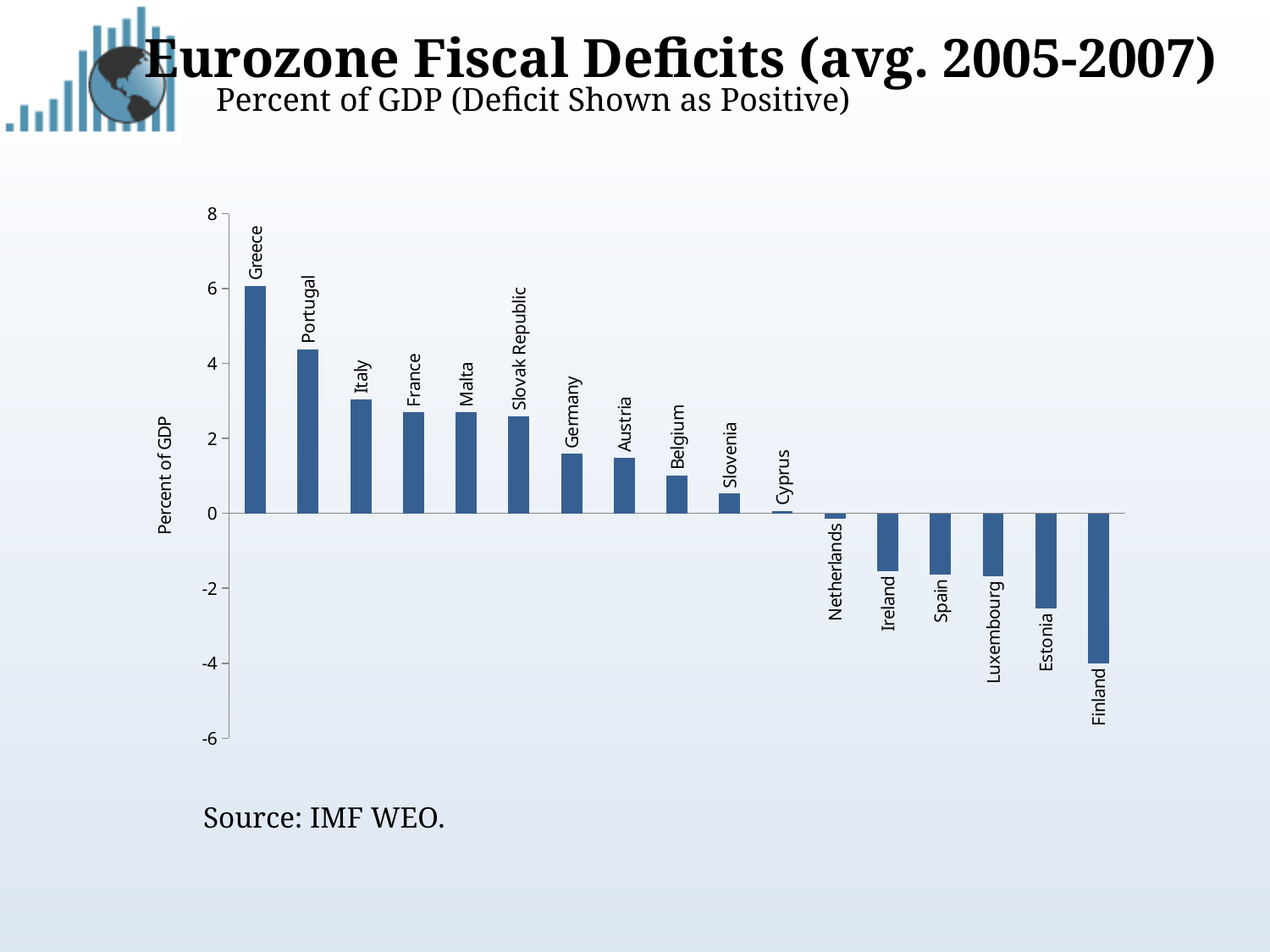
Which country has the highest fiscal deficit in the chart? Greece Do the values rise or fall moving from left to right along the x axis? Fall Which is larger, the value for Greece or the value for Portugal? Greece What is the label on the vertical axis of the chart? Percent of GDP Is the value for Greece greater or less than 4? greater Is the value for Germany greater or less than 2? less Is the value for Finland greater or less than -2? less What kind of chart is shown on the slide? Bar chart Which country has the lowest value in the chart? Finland How many countries are shown in the chart? 17